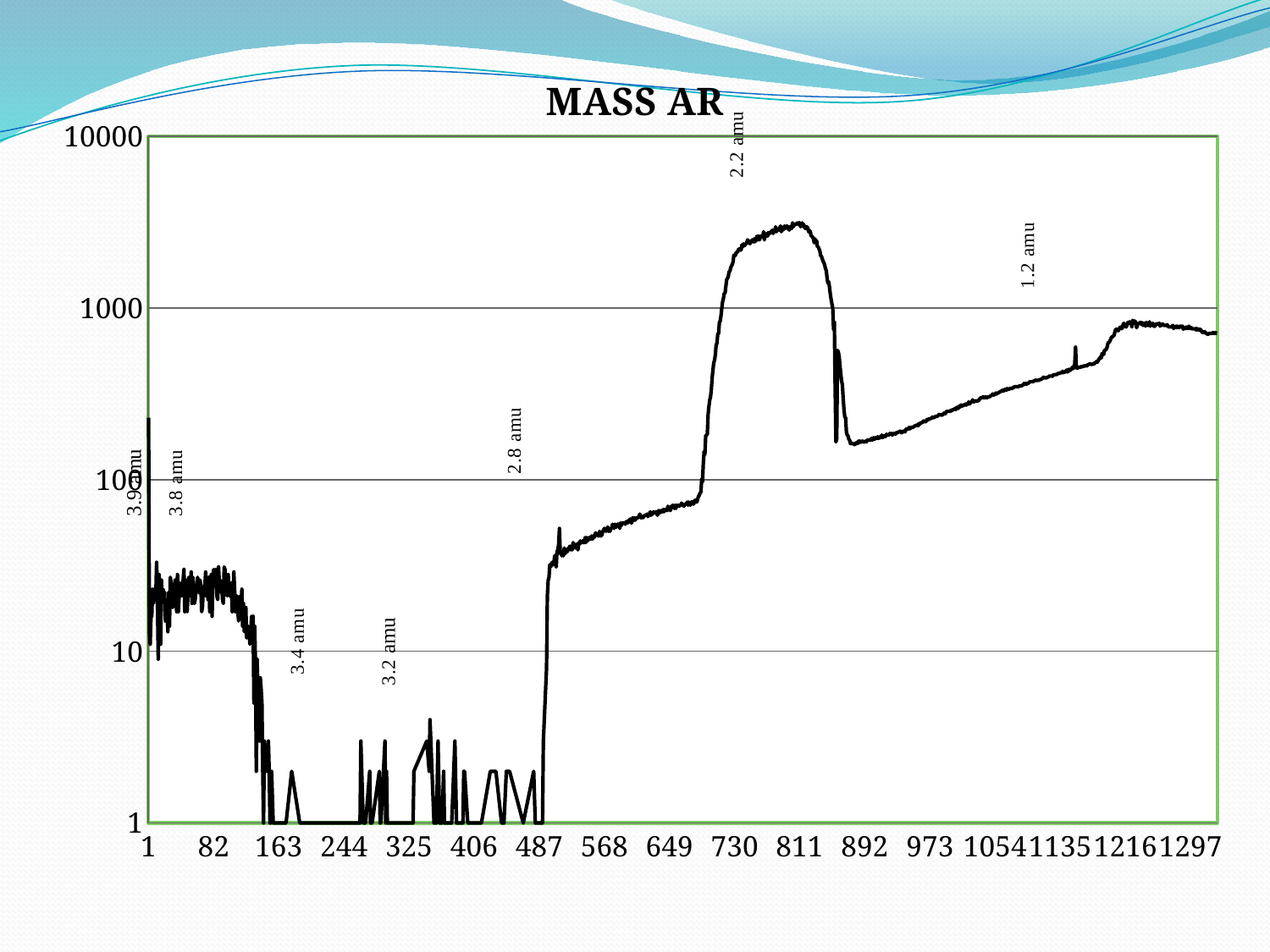
What is the title of the chart? MASS AR Between x = 892 and x = 1135, does the line rise or fall? rise What kind of chart is shown on the slide? line chart Is the value at x = 82 greater or less than 100? less Is the value at x = 811 greater or less than 1000? greater Which amu annotation is placed above the highest peak of the line? 2.2 amu Between x = 811 and x = 892, does the line rise or fall? fall Is the value at x = 1054 greater or less than 100? greater